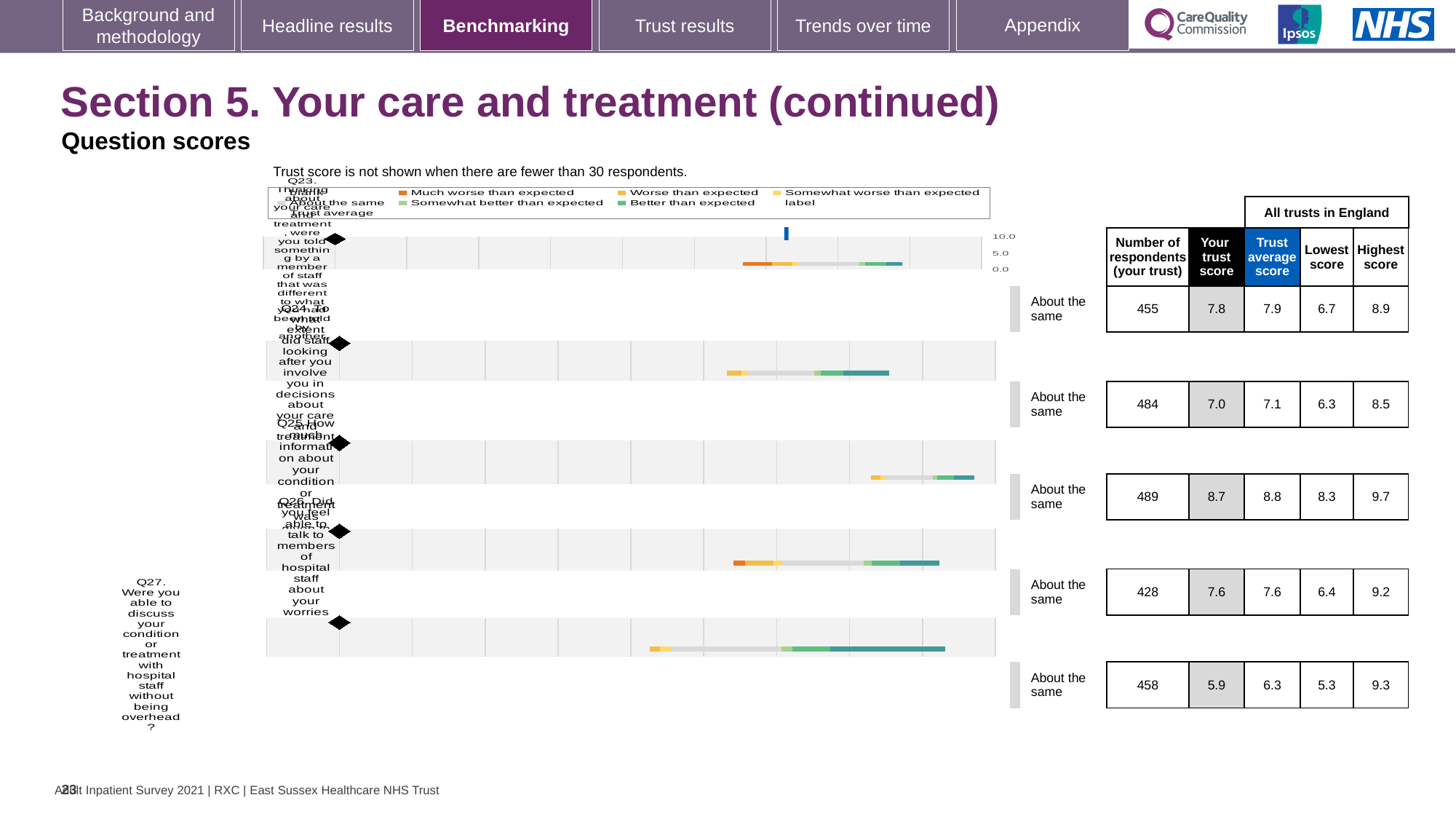
How many questions are plotted in the chart? 5 Which question has the lowest 'Your trust score'? Q27 What is the difference between the highest score and the lowest score for Q23? 2.2 What is the 'Your trust score' for Q25? 8.7 What is the highest score across all trusts in England for Q27? 9.3 What is the lowest score across all trusts in England for Q24? 6.3 What is the difference between the trust average score and your trust score for Q27? 0.4 For Q24, which is larger: your trust score or the trust average score? Trust average score Which question has the highest 'Your trust score'? Q25 How many respondents (your trust) are shown for Q23? 455 What benchmark category is shown for Q26? About the same Which question has the largest number of respondents (your trust)? Q25